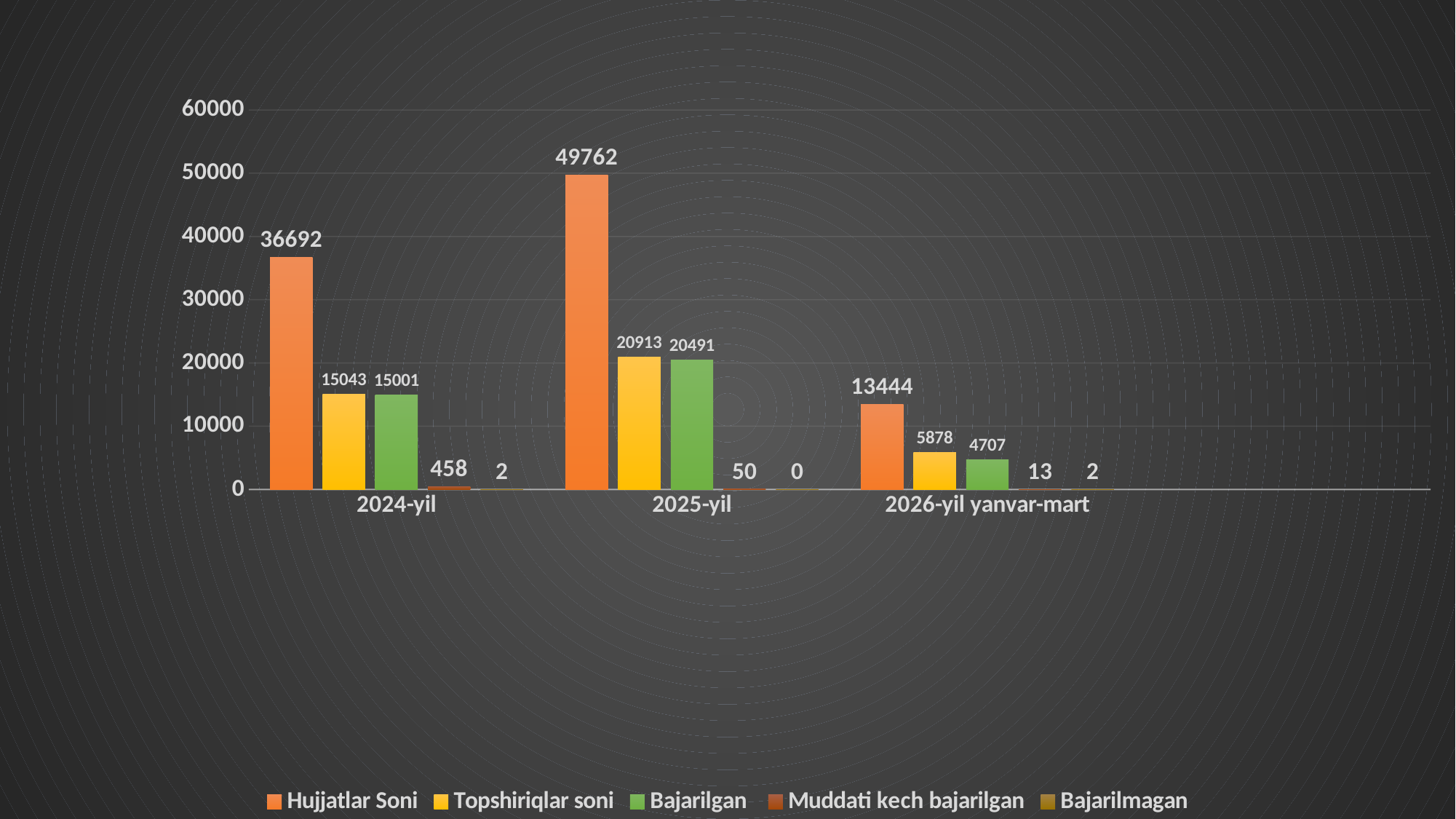
What is the value of Hujjatlar Soni for 2025-yil? 49762 What is the value of Bajarilgan for 2026-yil yanvar-mart? 4707 What is the difference between Hujjatlar Soni for 2025-yil and 2024-yil? 13070 Which is larger: Bajarilgan for 2024-yil or Bajarilgan for 2025-yil? Bajarilgan for 2025-yil How many series does the legend list? 5 How many categories are shown on the x axis? 3 Which category has the lowest Topshiriqlar soni value? 2026-yil yanvar-mart What is the value of Muddati kech bajarilgan for 2024-yil? 458 Which category has the highest Hujjatlar Soni value? 2025-yil What is the value of Topshiriqlar soni for 2024-yil? 15043 What is the difference between Topshiriqlar soni and Bajarilgan for 2025-yil? 422 What kind of chart is shown on the slide? Bar chart